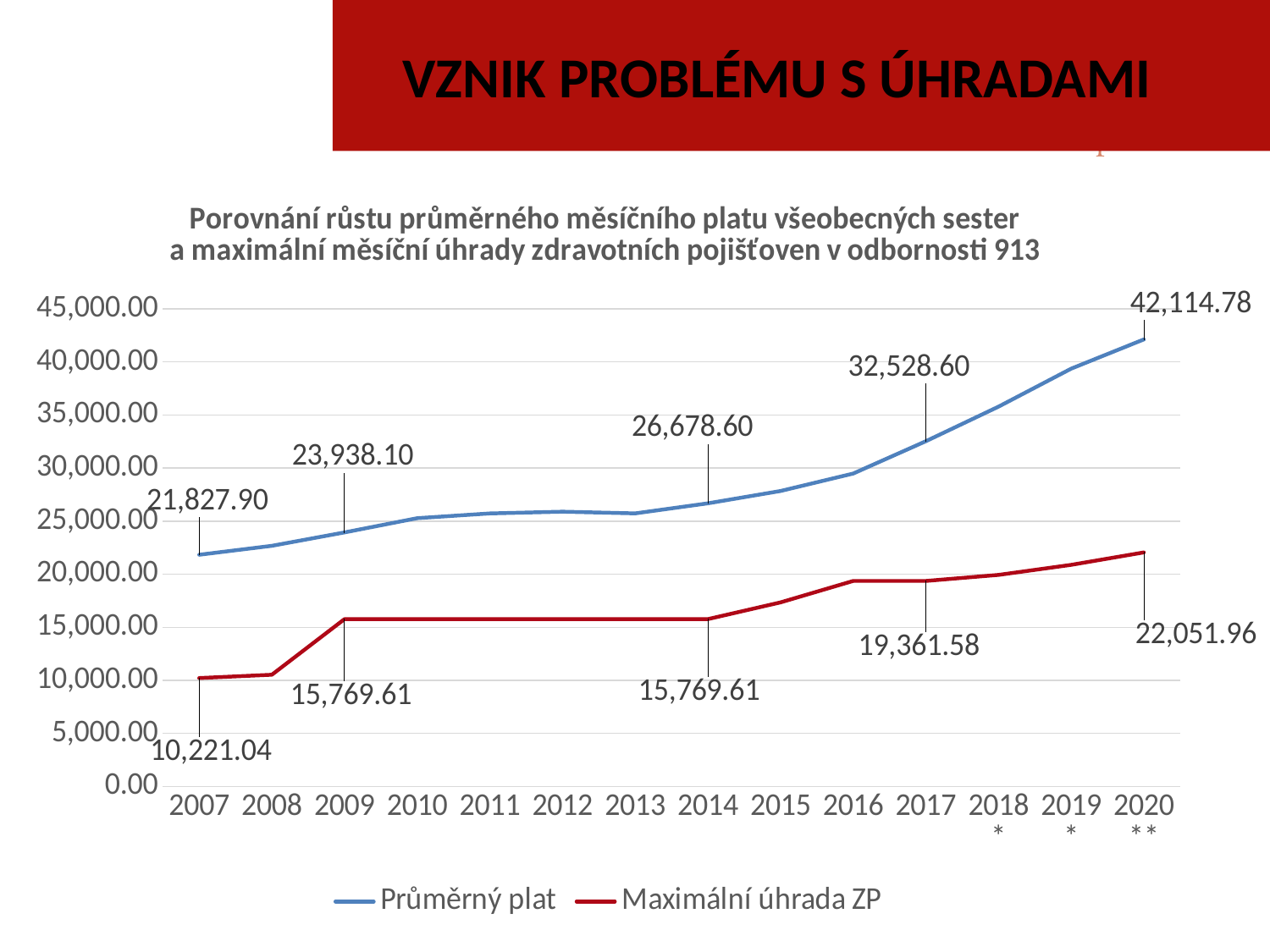
Which series has the higher value in 2017, Průměrný plat or Maximální úhrada ZP? Průměrný plat Does Průměrný plat rise or fall from 2007 to 2020? rise Is the value of Průměrný plat in 2019 greater or less than 35,000.00? greater What is the difference between Průměrný plat and Maximální úhrada ZP in 2007? 11,606.86 What is the value of Maximální úhrada ZP in 2007? 10,221.04 What is the value of Průměrný plat in 2017? 32,528.60 What type of chart is shown on the slide? line chart How many years are shown on the x axis? 14 What is the value of Průměrný plat in 2020? 42,114.78 How many series does the legend list? 2 What is the value of Maximální úhrada ZP in 2014? 15,769.61 What is the difference between Průměrný plat and Maximální úhrada ZP in 2020? 20,062.82